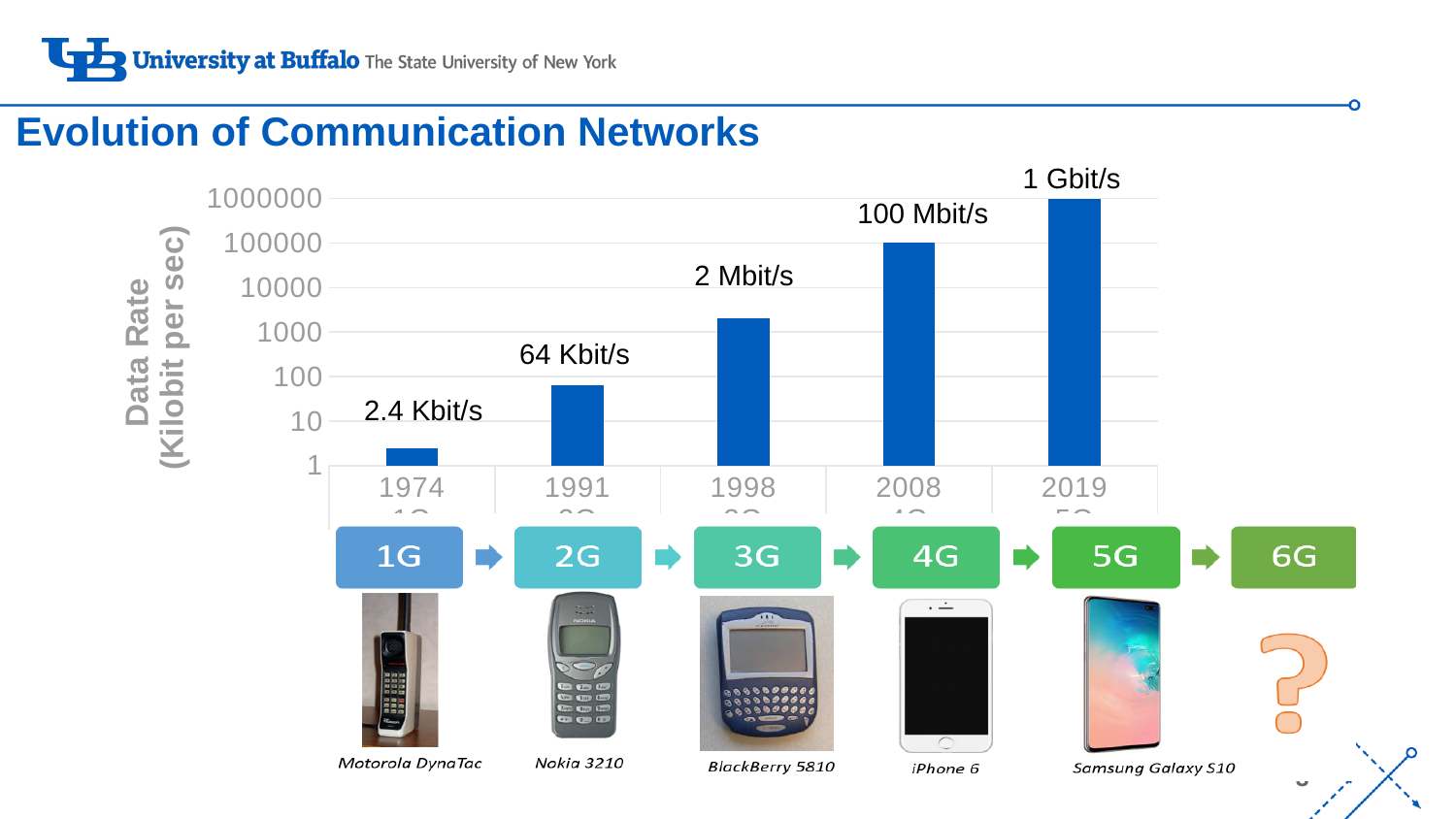
Which year has the lowest data rate? 1974 What data rate is shown for 2008? 100 Mbit/s Which year has the highest data rate? 2019 Is the value for 1998 greater or less than 1000 kilobit per sec? greater How many years are plotted on the chart? 5 What data rate is shown for 1991? 64 Kbit/s What data rate is shown for 1974? 2.4 Kbit/s What data rate is shown for 2019? 1 Gbit/s What is the difference between the data rates for 1991 and 1974? 61.6 Kbit/s What data rate is shown for 1998? 2 Mbit/s What kind of chart is shown? Bar chart Which has the larger data rate, 1998 or 2008? 2008